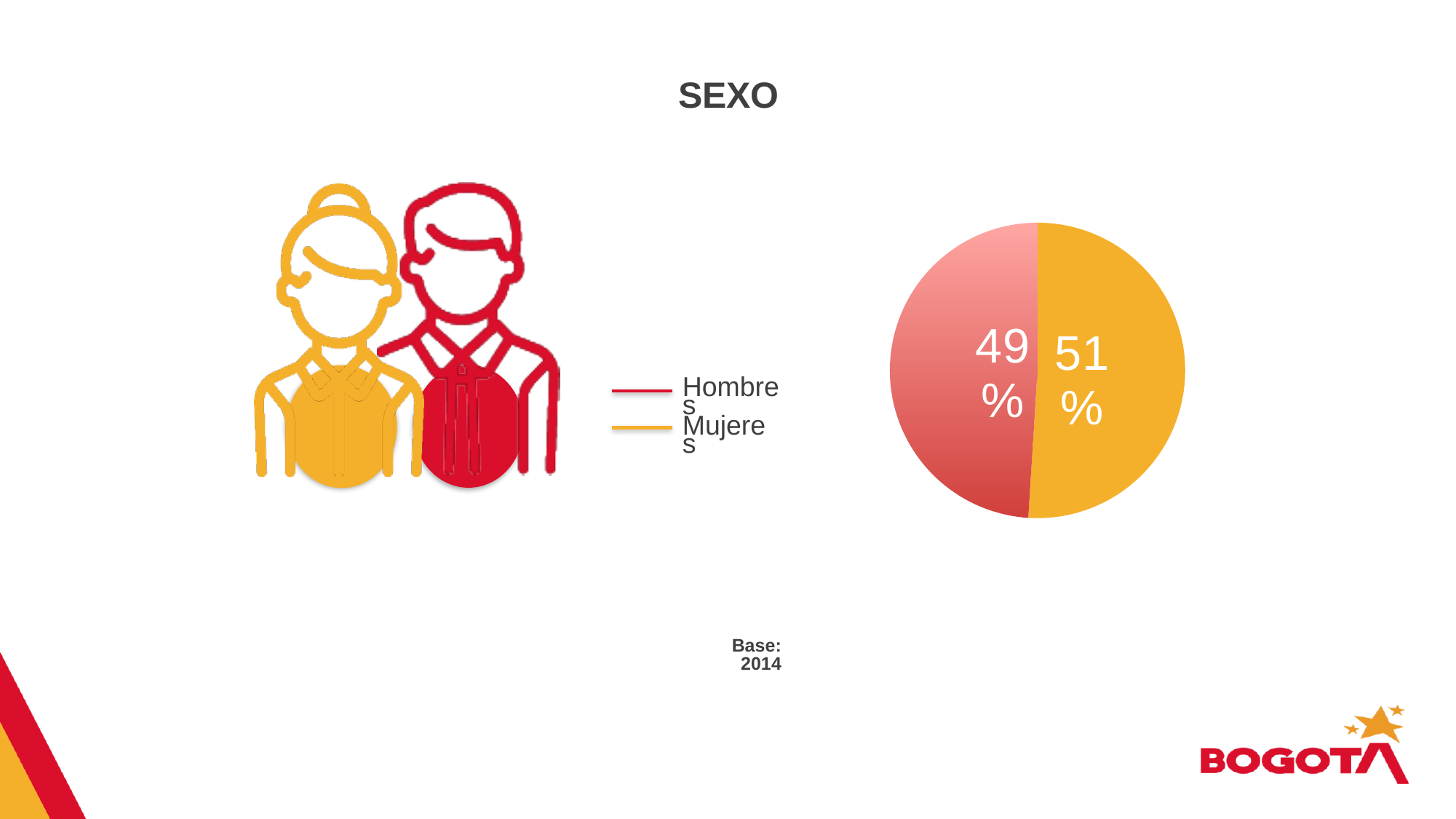
Which colour represents Hombres in the pie chart? red Is the share for Mujeres larger or smaller than the share for Hombres? larger What kind of chart is shown on the slide? pie chart What is the difference in percentage points between Mujeres and Hombres? 2 What is the title of the chart? SEXO How many slices does the pie chart have? 2 What percentage of the pie is Hombres? 49% Which category has the smaller share of the pie? Hombres How many entries does the legend list? 2 What percentage of the pie is Mujeres? 51% What is the base (sample size) shown below the chart? 2014 Which category has the larger share of the pie? Mujeres